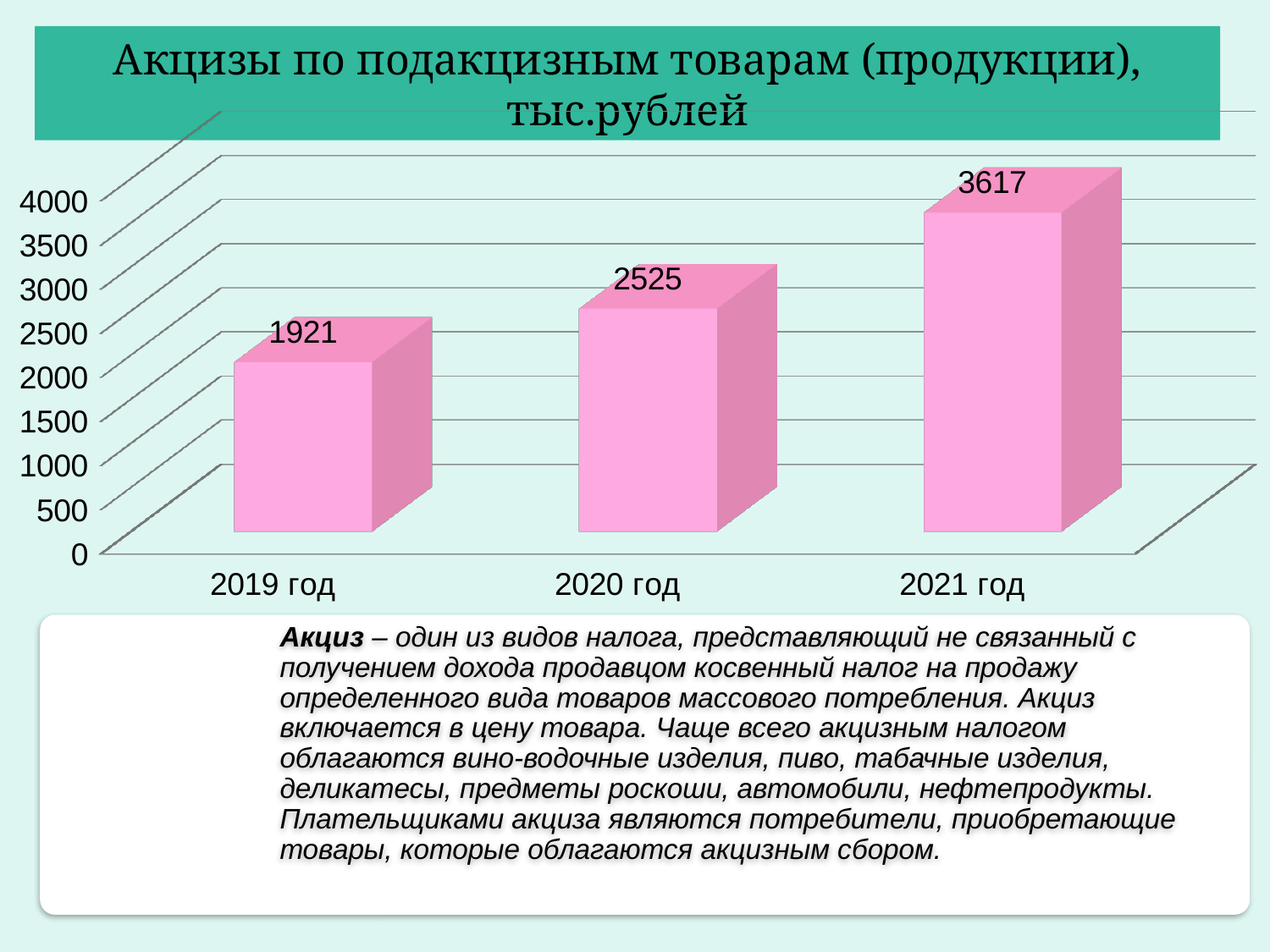
Do the values rise or fall from 2019 год to 2021 год? rise What is the difference between the values for 2020 год and 2019 год? 604 Which year has the lowest value? 2019 год Which year has the highest value? 2021 год Is the value for 2020 год greater or less than 3000? less Which is larger, the value for 2020 год or the value for 2021 год? 2021 год How many years are shown on the chart? 3 What is the value for 2021 год? 3617 What is the difference between the values for 2021 год and 2019 год? 1696 What is the value for 2020 год? 2525 What is the value for 2019 год? 1921 What kind of chart is shown on the slide? bar chart